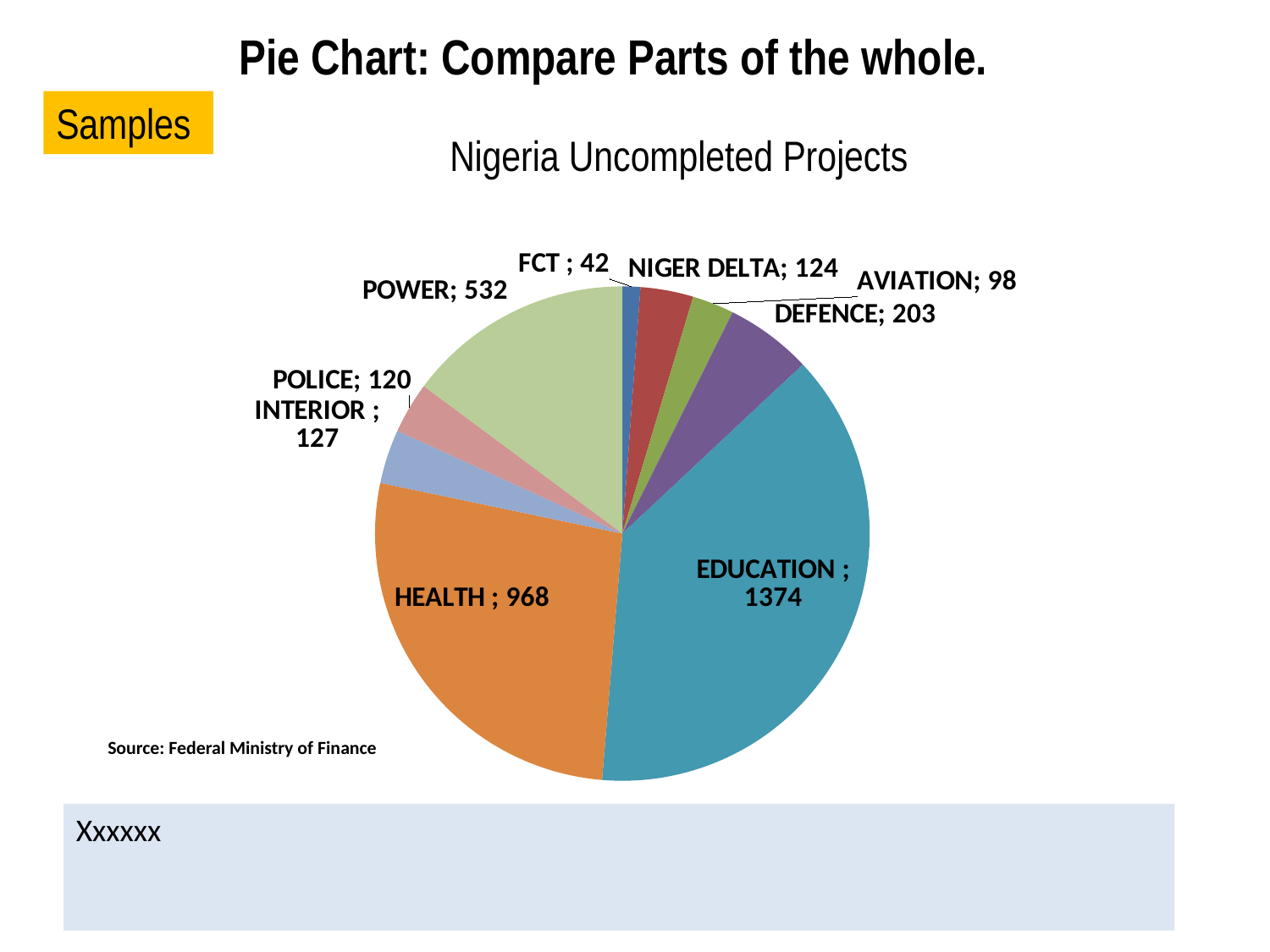
Which is larger, the value for DEFENCE or the value for NIGER DELTA? DEFENCE Which category has the smallest slice of the pie chart? FCT What is the source cited for the chart data? Federal Ministry of Finance What kind of chart is shown on the slide? Pie chart What is the value for EDUCATION in the Nigeria Uncompleted Projects pie chart? 1374 What is the value shown for POWER? 532 What is the difference between the values for EDUCATION and HEALTH? 406 How many categories are shown in the pie chart? 9 What is the value for HEALTH in the pie chart? 968 Which category has the largest slice of the pie chart? EDUCATION What is the title of the chart? Nigeria Uncompleted Projects What is the value shown for DEFENCE? 203